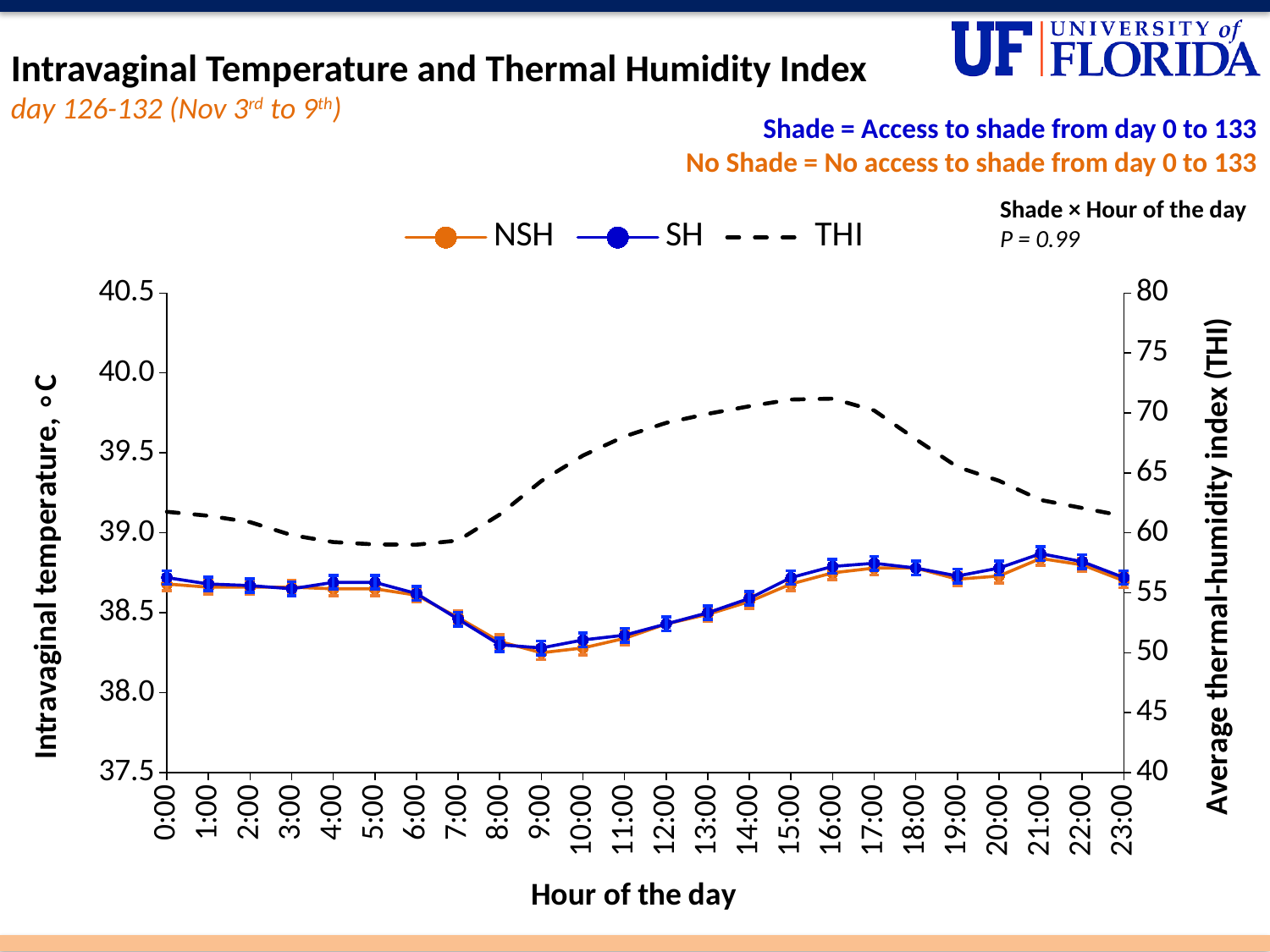
Is the THI value at 5:00 greater or less than 65? less What is the label of the right-hand vertical axis? Average thermal-humidity index (THI) At which hour of the day is the SH intravaginal temperature lowest? 9:00 Does the THI series rise or fall between 6:00 and 16:00? rise Does the SH intravaginal temperature rise or fall between 5:00 and 9:00? fall How many hours of the day are plotted along the x axis? 24 Is the SH intravaginal temperature at 9:00 greater or less than 38.5? less What kind of chart is shown on the slide? line chart At which hour of the day does the THI series reach its highest value? 16:00 How many series does the legend list? 3 Is the THI value at 16:00 greater or less than 65? greater